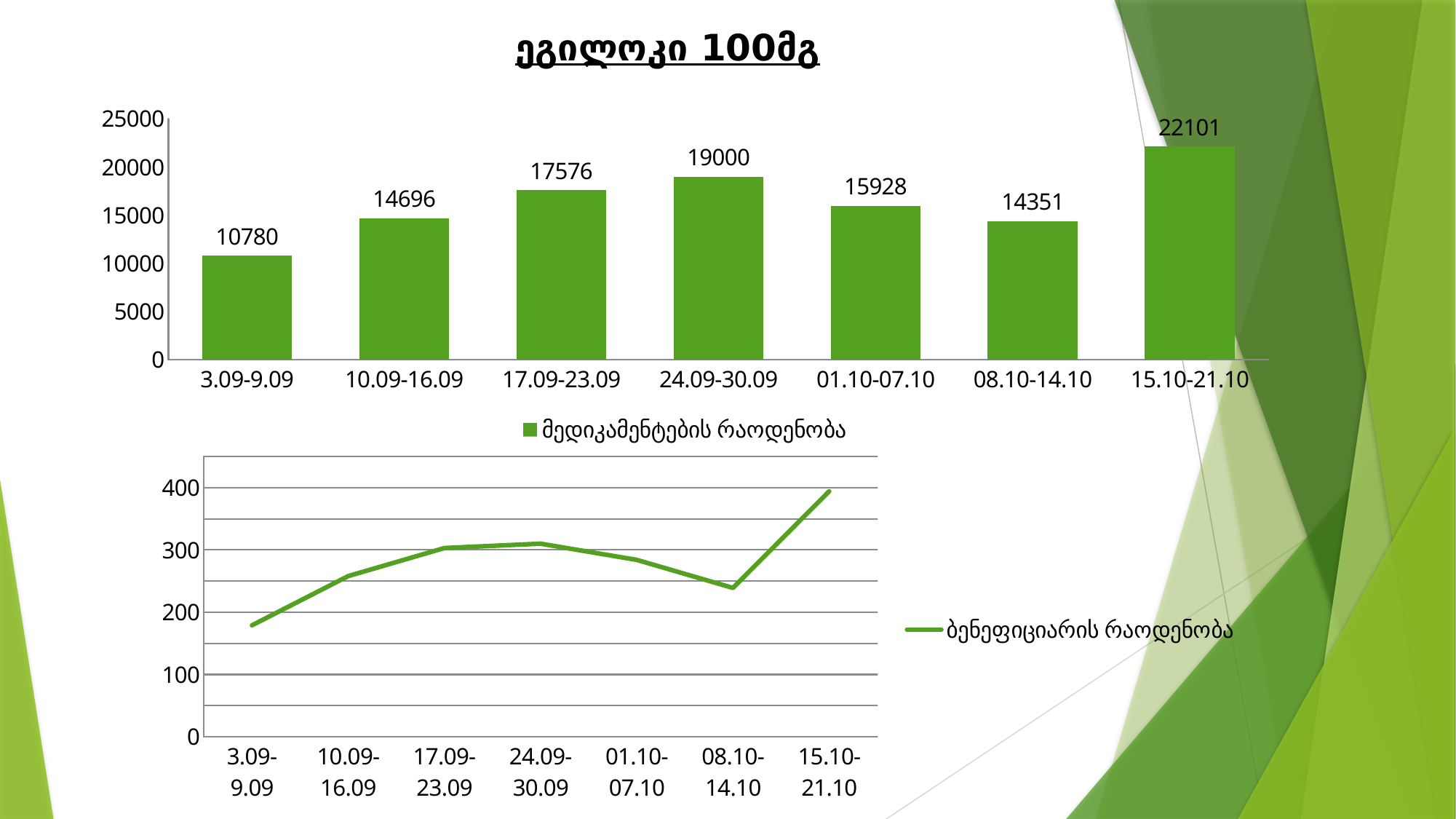
In the top bar chart, which week has the lowest value? 3.09-9.09 What type of chart is the bottom chart on the slide? line chart In the bottom line chart, which week has the highest value? 15.10-21.10 In the top bar chart, which week has the highest value? 15.10-21.10 In the bottom line chart, is the value for 3.09-9.09 greater or less than 200? less In the top bar chart, what is the value for 3.09-9.09? 10780 In the top bar chart, what is the value for 24.09-30.09? 19000 In the top bar chart, which is larger: the value for 17.09-23.09 or the value for 01.10-07.10? 17.09-23.09 How many bars are in the top bar chart? 7 In the bottom line chart, is the value for 15.10-21.10 greater or less than 350? greater What type of chart is the top chart on the slide? bar chart In the top bar chart, what is the difference between the values for 15.10-21.10 and 08.10-14.10? 7750